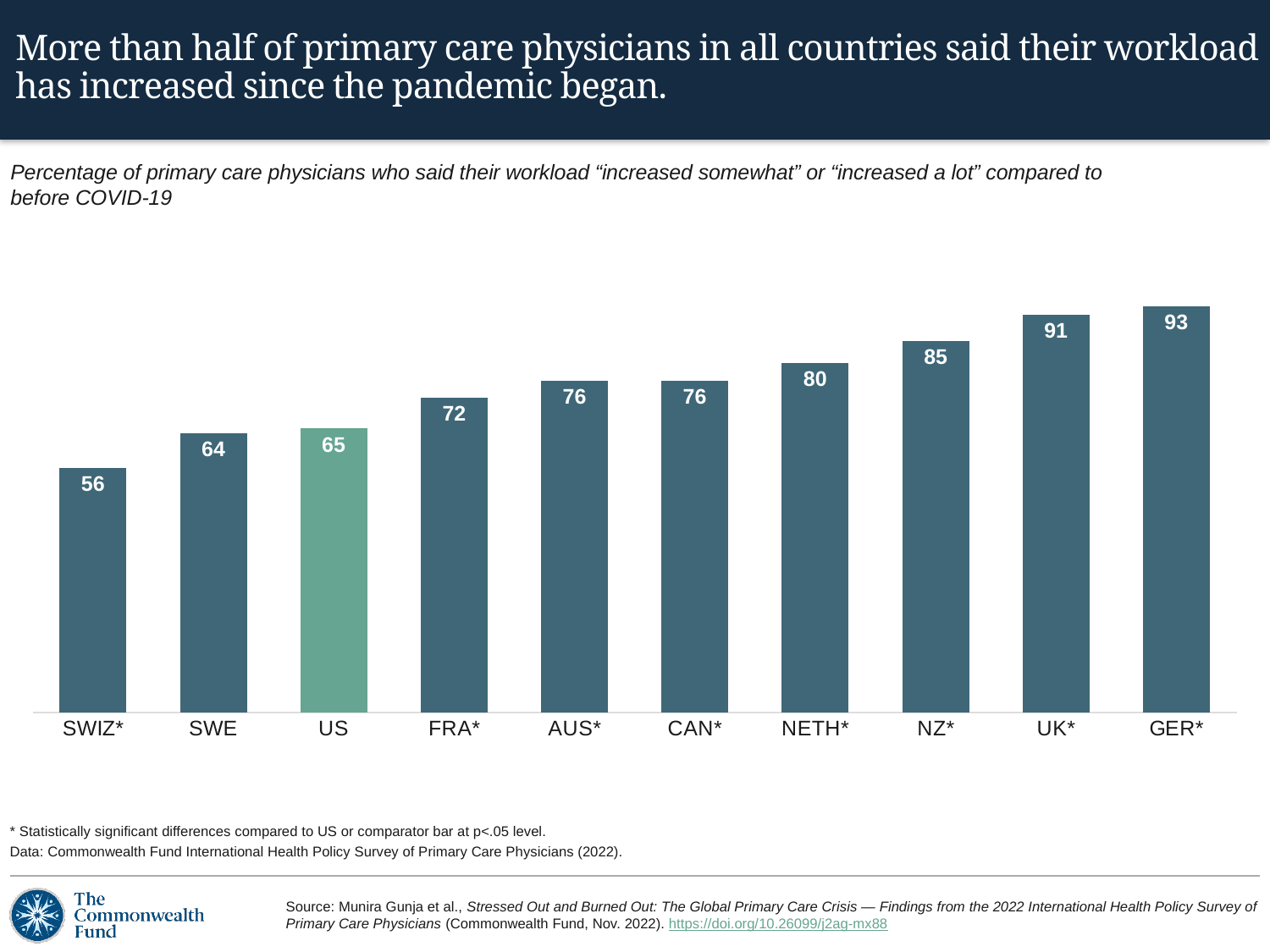
What kind of chart is shown on the slide? Bar chart Which country's bar is shown in a different colour (green) from the others? US Do the values rise or fall from left to right across the chart? Rise Which country has the highest value? GER* What is the value for the US? 65 Which is larger, the value for FRA* or the value for NZ*? NZ* Which country has the lowest value? SWIZ* What is the value for SWE? 64 What is the value for NETH*? 80 What is the difference between the values for UK* and US? 26 What is the difference between the values for GER* and SWIZ*? 37 How many countries are shown in the chart? 10